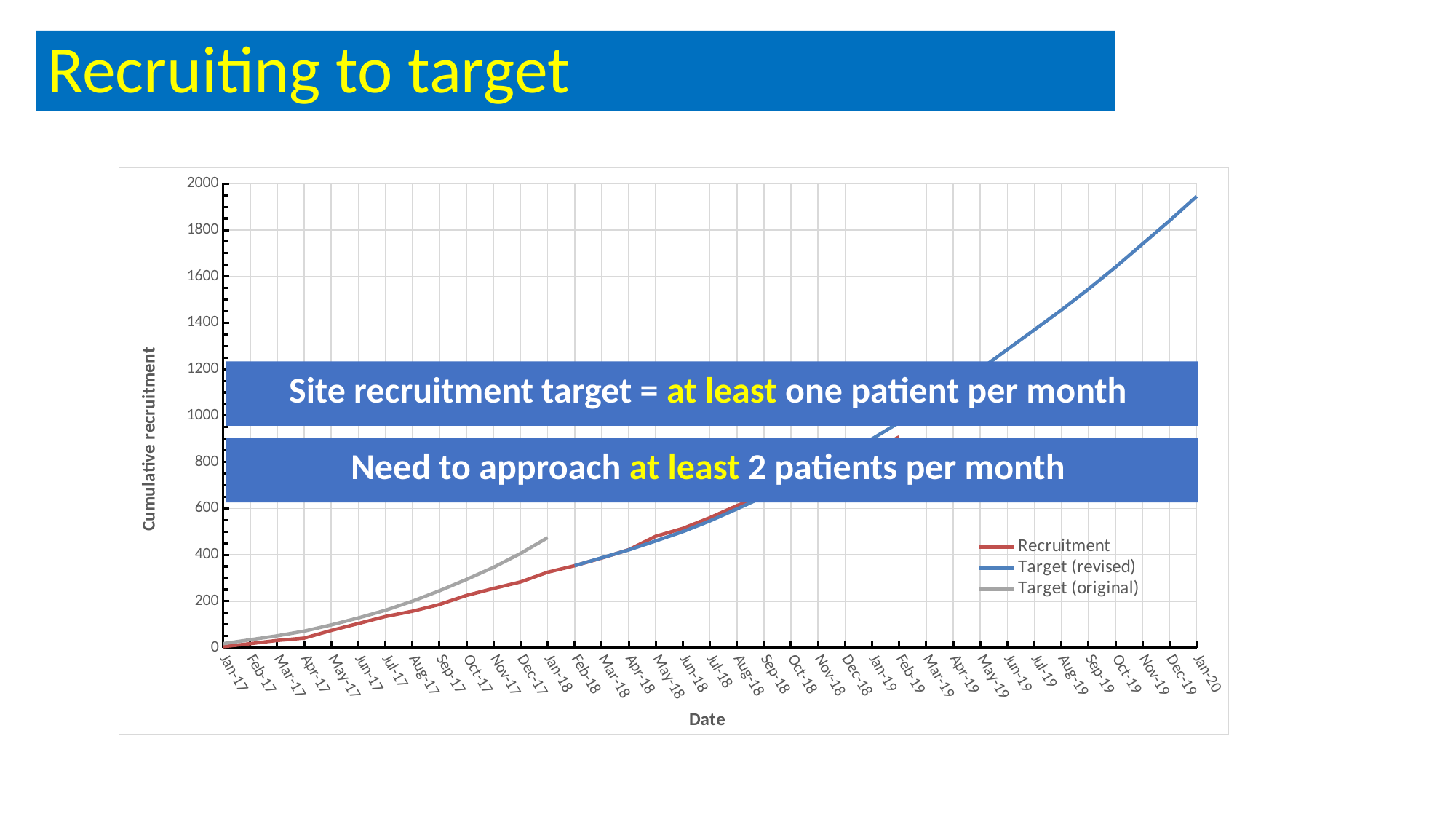
What kind of chart is shown on the slide? Line chart At Jan-18, which is larger: Target (original) or Recruitment? Target (original) Does the Target (revised) line rise or fall along the x axis? Rise Is the value of Recruitment at Jan-18 greater or less than 400? less What are the three series named in the legend? Recruitment, Target (revised), Target (original) How many series does the chart legend list? 3 What is the title of the vertical axis? Cumulative recruitment What is the first month label on the x axis? Jan-17 Is the value of Target (original) at Jan-18 greater or less than 400? greater Which series reaches the highest value on the chart? Target (revised) Is the value of Target (revised) at Jan-20 greater or less than 2000? less